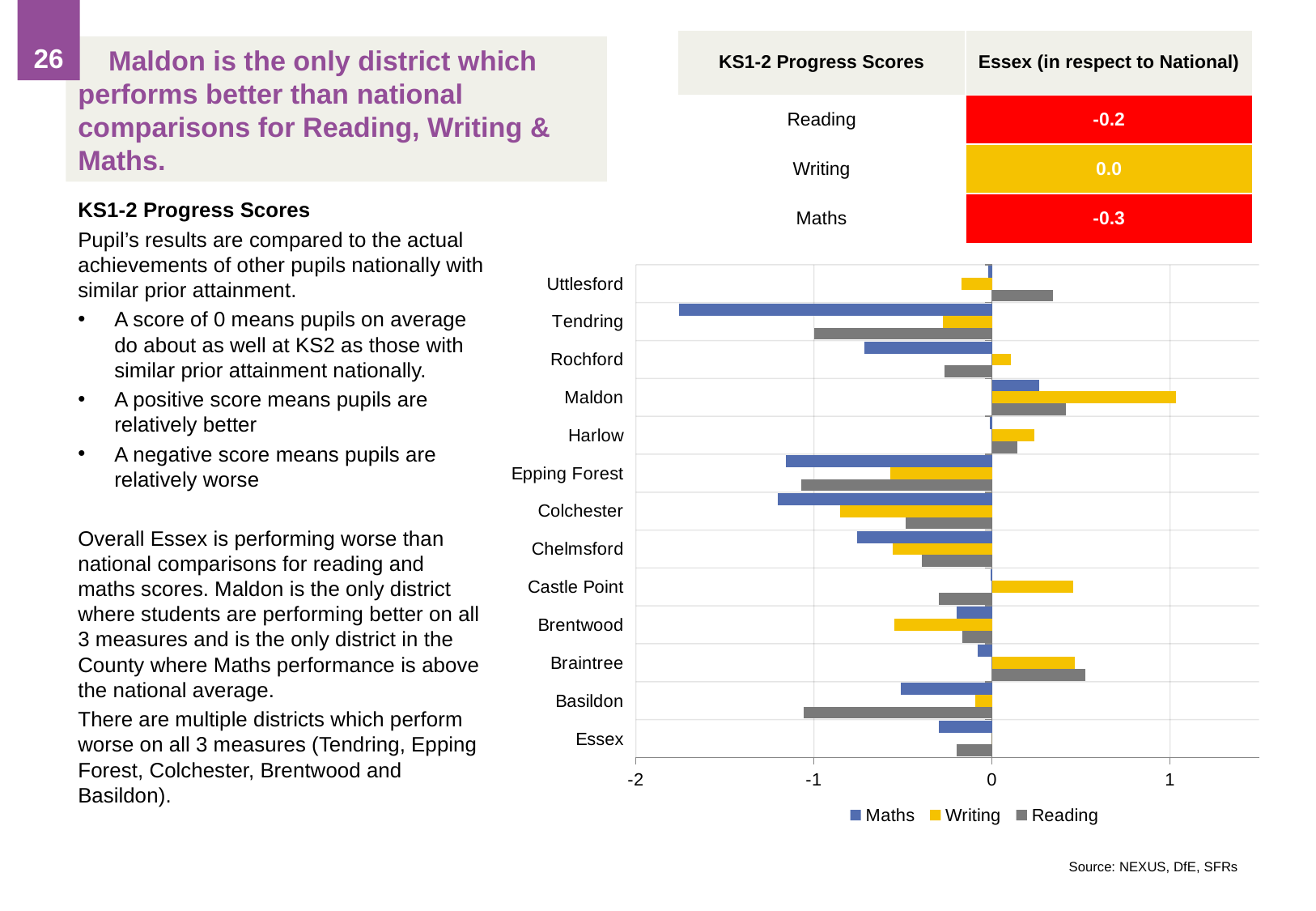
Which district has the highest Writing progress score on the chart? Maldon Which is larger for Maldon: the Writing value or the Maths value? Writing Which district has the larger Maths value: Tendring or Rochford? Rochford Is the Maths value for Colchester greater or less than -1? less Is the Maths value for Tendring greater or less than -1? less What kind of chart is shown on the slide? bar chart Is the Reading value for Braintree greater or less than 0? greater Which district has the lowest Maths progress score on the chart? Tendring Which colour represents the Writing series in the chart? yellow How many series does the chart legend list? 3 How many districts (categories) are plotted on the chart? 13